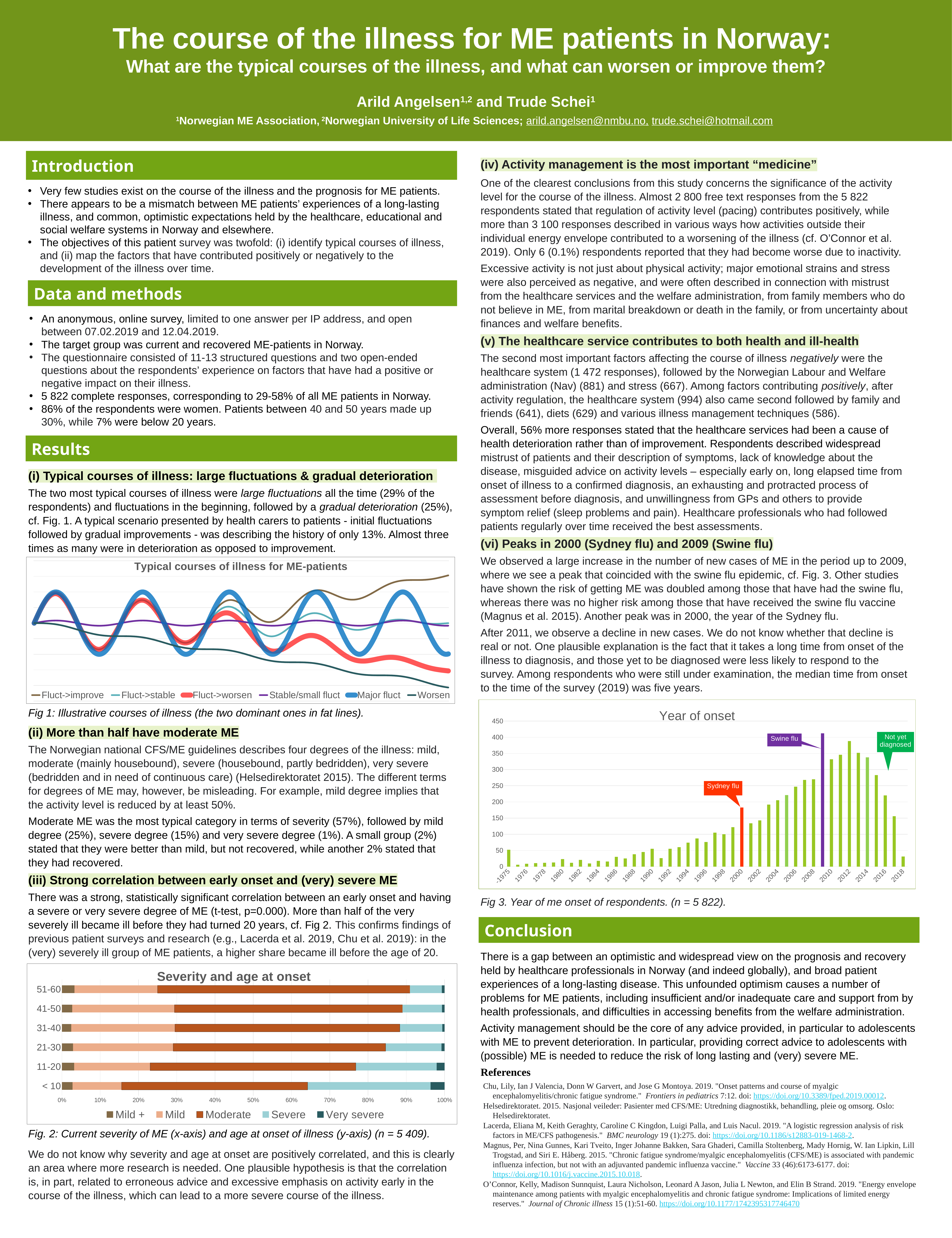
How many series does the legend of the 'Typical courses of illness for ME-patients' chart list? 6 In the 'Severity and age at onset' chart, which age group has the smallest Mild segment? < 10 In the 'Year of onset' chart, is the value for 2000 greater or less than 150? greater How many age-group categories are shown on the y axis of the 'Severity and age at onset' chart? 6 In the 'Year of onset' chart, which year has the highest bar? 2009 In the 'Severity and age at onset' chart, which age group has the largest Severe segment? < 10 What kind of chart is the 'Typical courses of illness for ME-patients' chart (Fig 1)? line chart What kind of chart is the 'Severity and age at onset' chart (Fig 2)? stacked bar chart How many series does the legend of the 'Severity and age at onset' chart list? 5 In the 'Year of onset' chart, is the value for 2018 greater or less than 50? less In the 'Typical courses of illness for ME-patients' chart, which two series are drawn with fat lines? Fluct->worsen and Major fluct What kind of chart is the 'Year of onset' chart (Fig 3)? bar chart